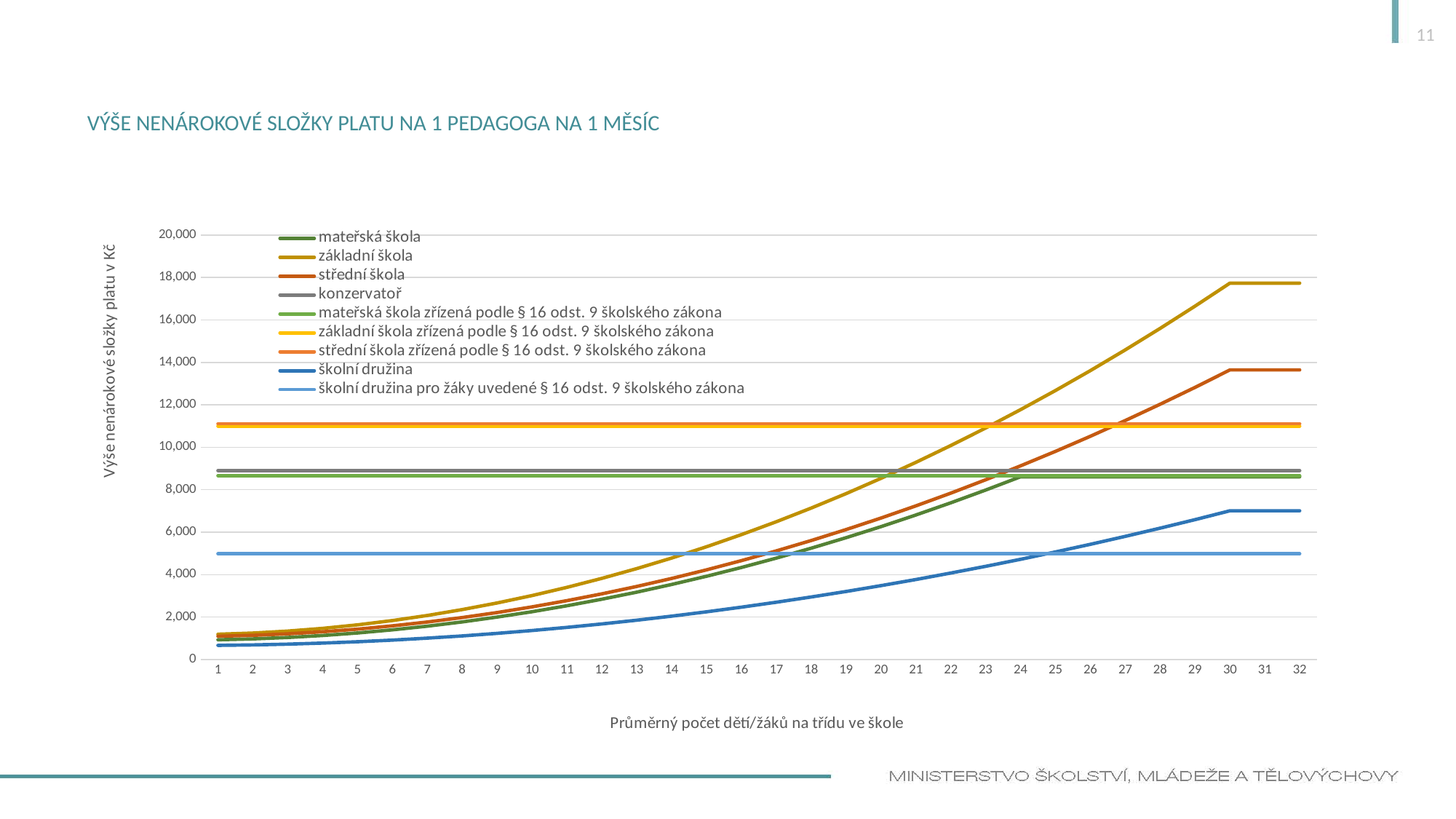
Does the value for základní škola rise or fall as the average number of pupils per class increases from 1 to 30? rises Which series has the lowest value at 32 pupils per class? školní družina pro žáky uvedené § 16 odst. 9 školského zákona At 32 pupils per class, which is larger: the value for základní škola or the value for střední škola? základní škola Is the value for školní družina at 32 pupils per class greater or less than 6,000? greater Is the value for základní škola at 32 pupils per class greater or less than 16,000? greater How many values are shown on the x axis (Průměrný počet dětí/žáků na třídu ve škole)? 32 How many series does the legend list? 9 At 32 pupils per class, which is larger: the value for konzervatoř or the value for školní družina? konzervatoř What kind of chart is shown on the slide? line chart Is the value for střední škola at 32 pupils per class greater or less than 12,000? greater Which series has the highest value at 32 pupils per class? základní škola What is the title of the chart? VÝŠE NENÁROKOVÉ SLOŽKY PLATU NA 1 PEDAGOGA NA 1 MĚSÍC